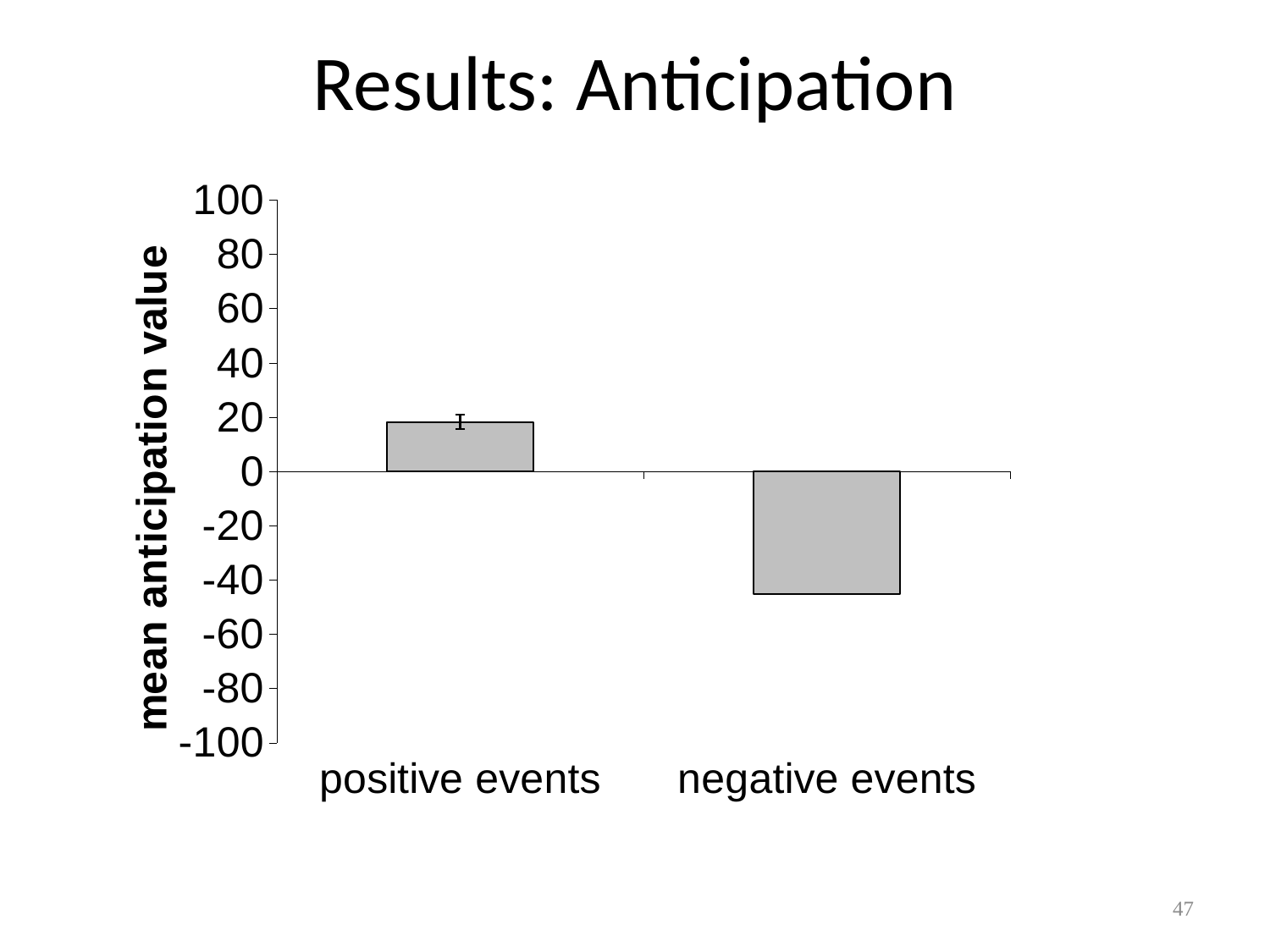
Which category has the lowest mean anticipation value? negative events Is the value for positive events greater or less than 40? less Which is larger, the value for positive events or the value for negative events? positive events Do the values rise or fall from positive events to negative events? fall Is the value for negative events greater or less than 0? less What is the label on the vertical axis? mean anticipation value Which category has the highest mean anticipation value? positive events What is the title of the slide? Results: Anticipation How many categories are plotted on the x axis? 2 Is the value for positive events greater or less than 0? greater What kind of chart is shown on the slide? bar chart